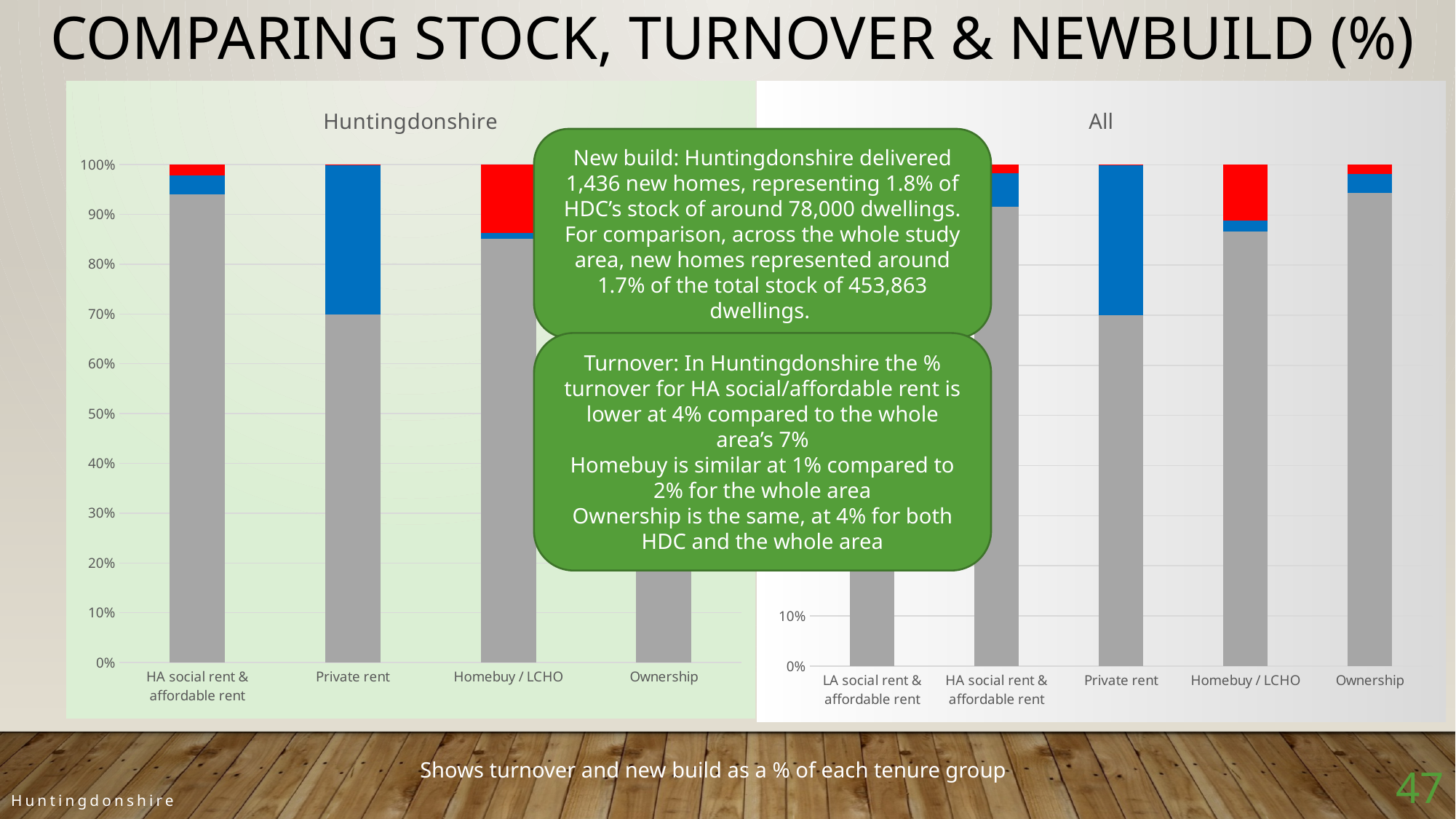
How many tenure categories are shown on the x axis of the All chart? 5 In the All chart, is the grey segment for Private rent greater or less than 80%? less What is the title of the chart on the right side of the slide? All In the Huntingdonshire chart, is the grey segment for HA social rent & affordable rent greater or less than 90%? greater In the All chart, is the grey segment for Ownership greater or less than 90%? greater In the All chart, which has the larger red segment: Homebuy / LCHO or Ownership? Homebuy / LCHO In the All chart, which category has the smallest grey segment? Private rent How many tenure categories are shown on the x axis of the Huntingdonshire chart? 4 What type of chart is the Huntingdonshire chart on the left? Stacked bar chart In the Huntingdonshire chart, which has the larger grey segment: Private rent or Homebuy / LCHO? Homebuy / LCHO